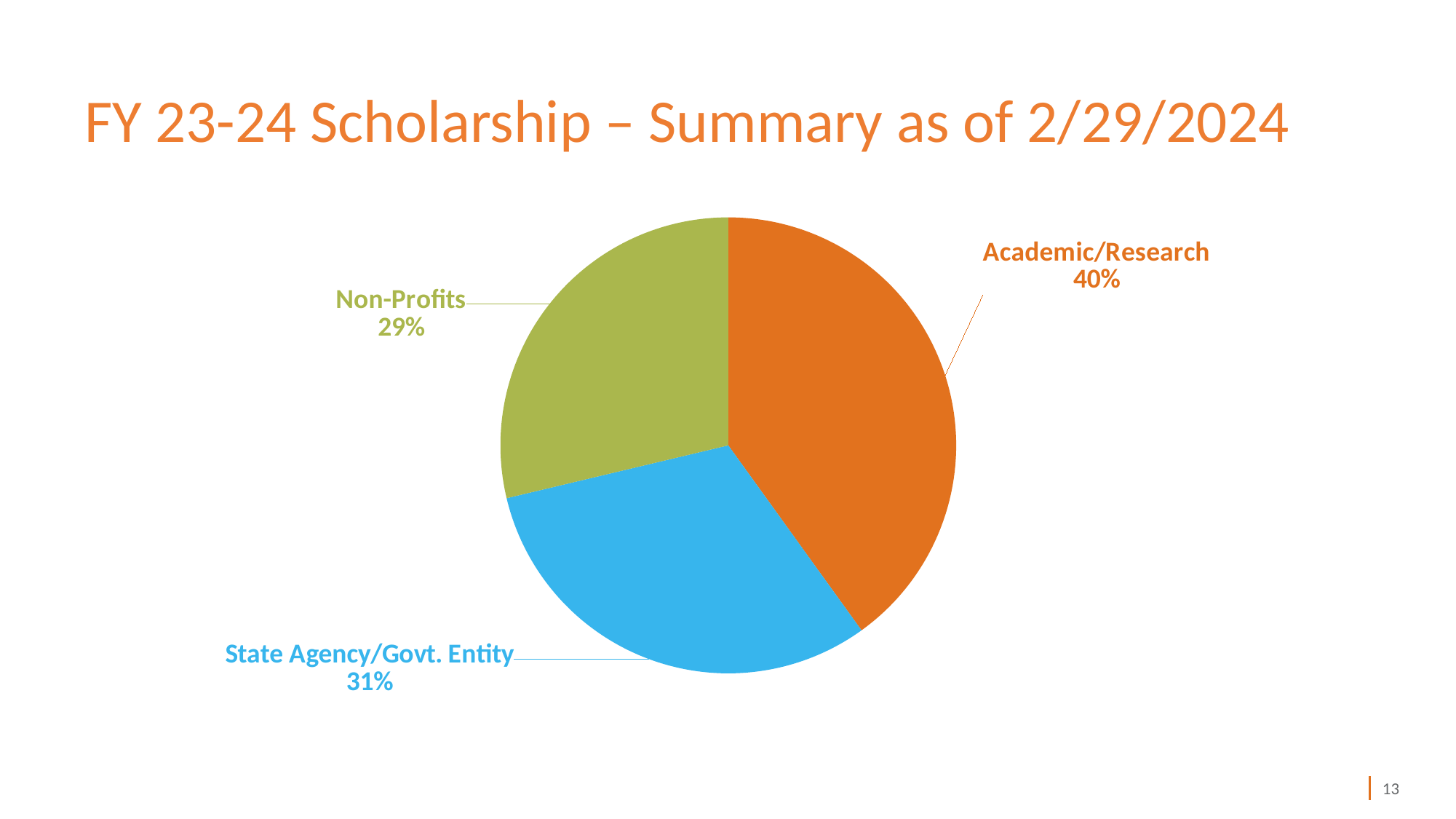
What share of the pie does Academic/Research hold? 40% What is the difference in percentage points between State Agency/Govt. Entity and Non-Profits? 2 What type of chart is shown on the slide? Pie chart What is the difference in percentage points between Academic/Research and Non-Profits? 11 Which category has the smallest share of the pie? Non-Profits What is the title of the slide containing the pie chart? FY 23-24 Scholarship – Summary as of 2/29/2024 Which is larger, the share for Academic/Research or the share for State Agency/Govt. Entity? Academic/Research Which category has the largest share of the pie? Academic/Research What share of the pie does Non-Profits hold? 29% How many slices does the pie chart have? 3 What colour is the Academic/Research slice? Orange What share of the pie does State Agency/Govt. Entity hold? 31%